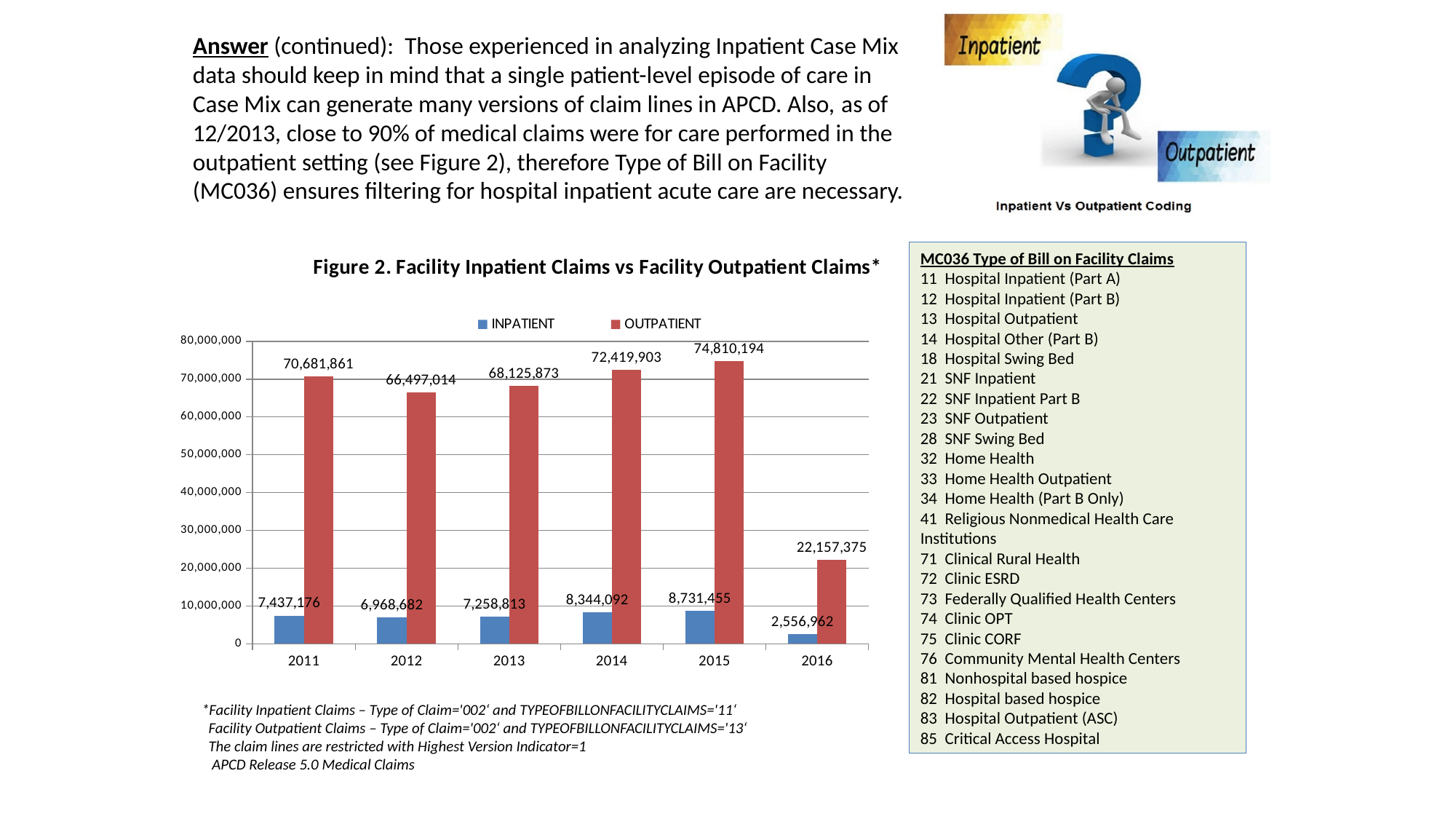
What is the OUTPATIENT value for 2016? 22,157,375 What is the INPATIENT value for 2014? 8,344,092 What is the difference between the OUTPATIENT and INPATIENT values in 2015? 66,078,739 Which year has the highest OUTPATIENT value? 2015 What is the OUTPATIENT value for 2011? 70,681,861 What kind of chart is Figure 2? bar chart How many years are shown on the x axis? 6 Is the OUTPATIENT value for 2016 greater or less than 30,000,000? less Which year has the lowest INPATIENT value? 2016 What is the difference between the OUTPATIENT values for 2014 and 2013? 4,294,030 How many series does the legend list? 2 Which is larger, the INPATIENT value for 2012 or the INPATIENT value for 2013? 2013